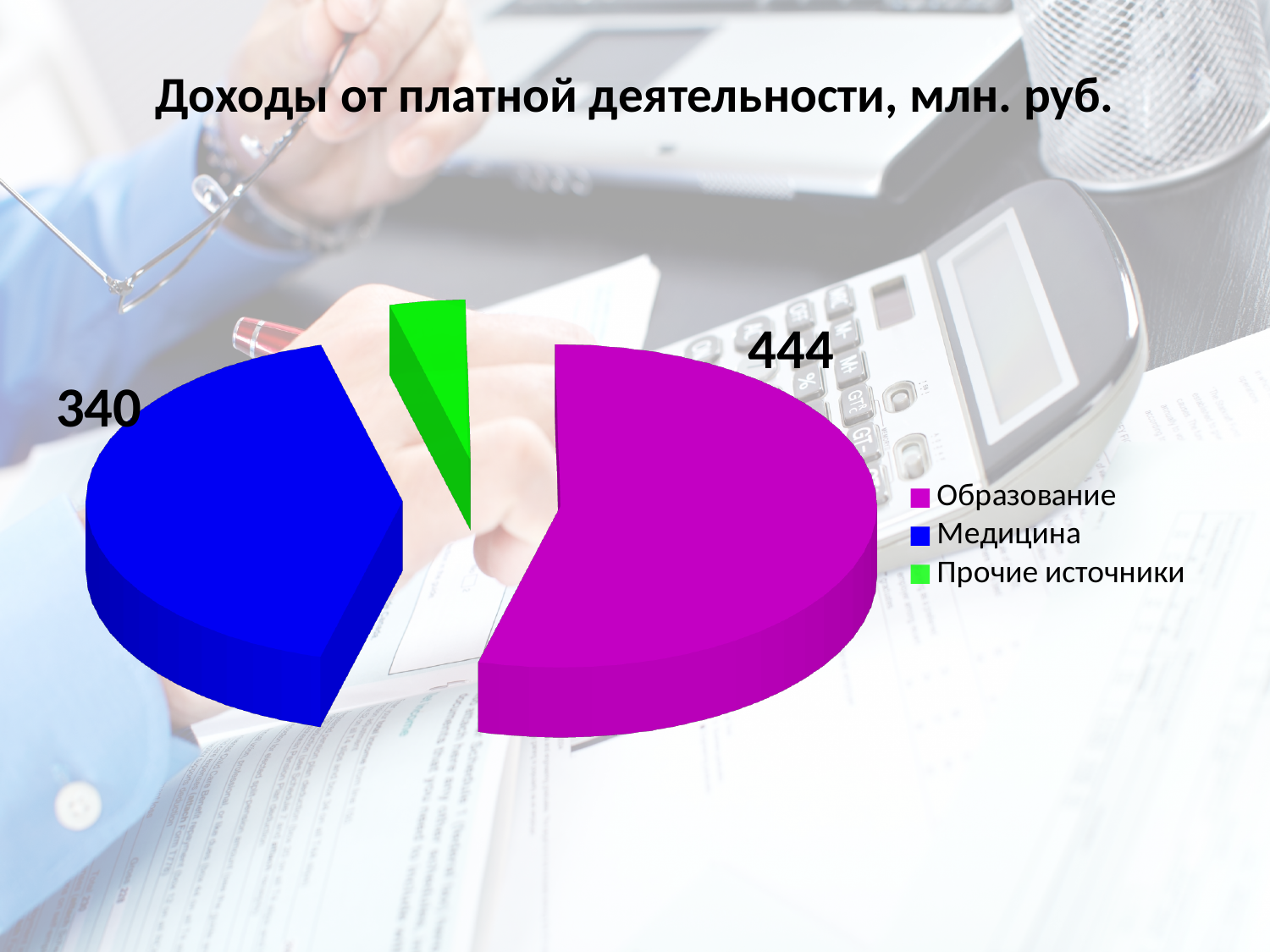
What colour is the slice for Медицина? Blue What is the value for Образование in the pie chart? 444 What is the difference between the values for Образование and Медицина? 104 Which category has the largest slice in the pie chart? Образование How many slices does the pie chart have? 3 What is the value for Медицина in the pie chart? 340 How many entries does the legend list? 3 Which is larger, the value for Образование or the value for Медицина? Образование What kind of chart is shown on the slide? Pie chart What is the title of the chart? Доходы от платной деятельности, млн. руб. Which category has the smallest slice in the pie chart? Прочие источники